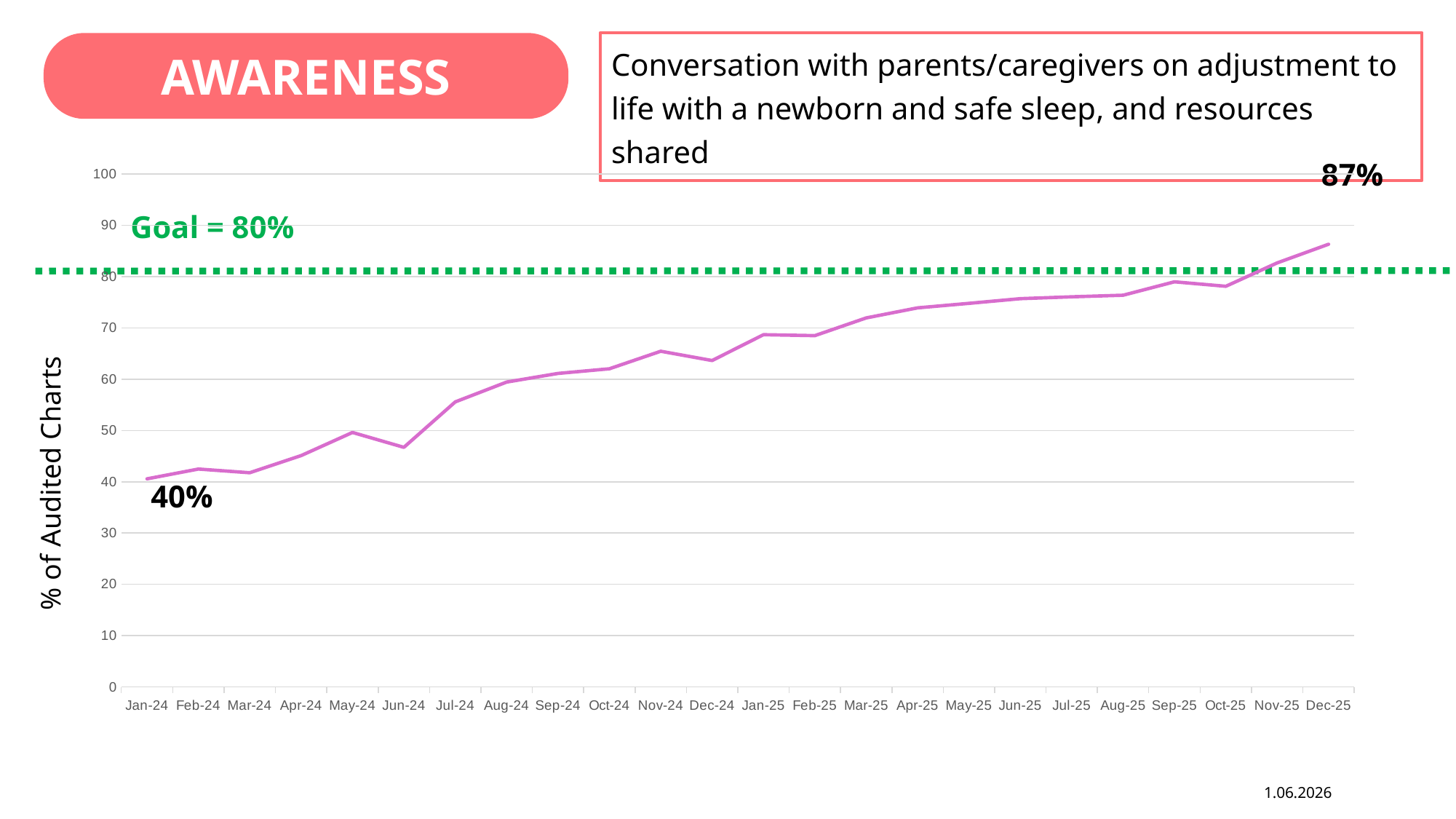
Which month has the lowest value? Jan-24 What is the value for Dec-25? 87% How many monthly data points are plotted on the chart? 24 What goal value is marked by the dotted line on the chart? 80% Do the values generally rise or fall from Jan-24 to Dec-25? rise What is the value for Jan-24? 40% What is the difference between the Dec-25 value and the Jan-24 value? 47 percentage points Is the value for Nov-24 greater or less than 60? greater Which is larger, the value for Jun-24 or the value for Jul-24? Jul-24 Is the value for Jun-24 greater or less than 50? less What kind of chart is shown on the slide? line chart Which month has the highest value? Dec-25